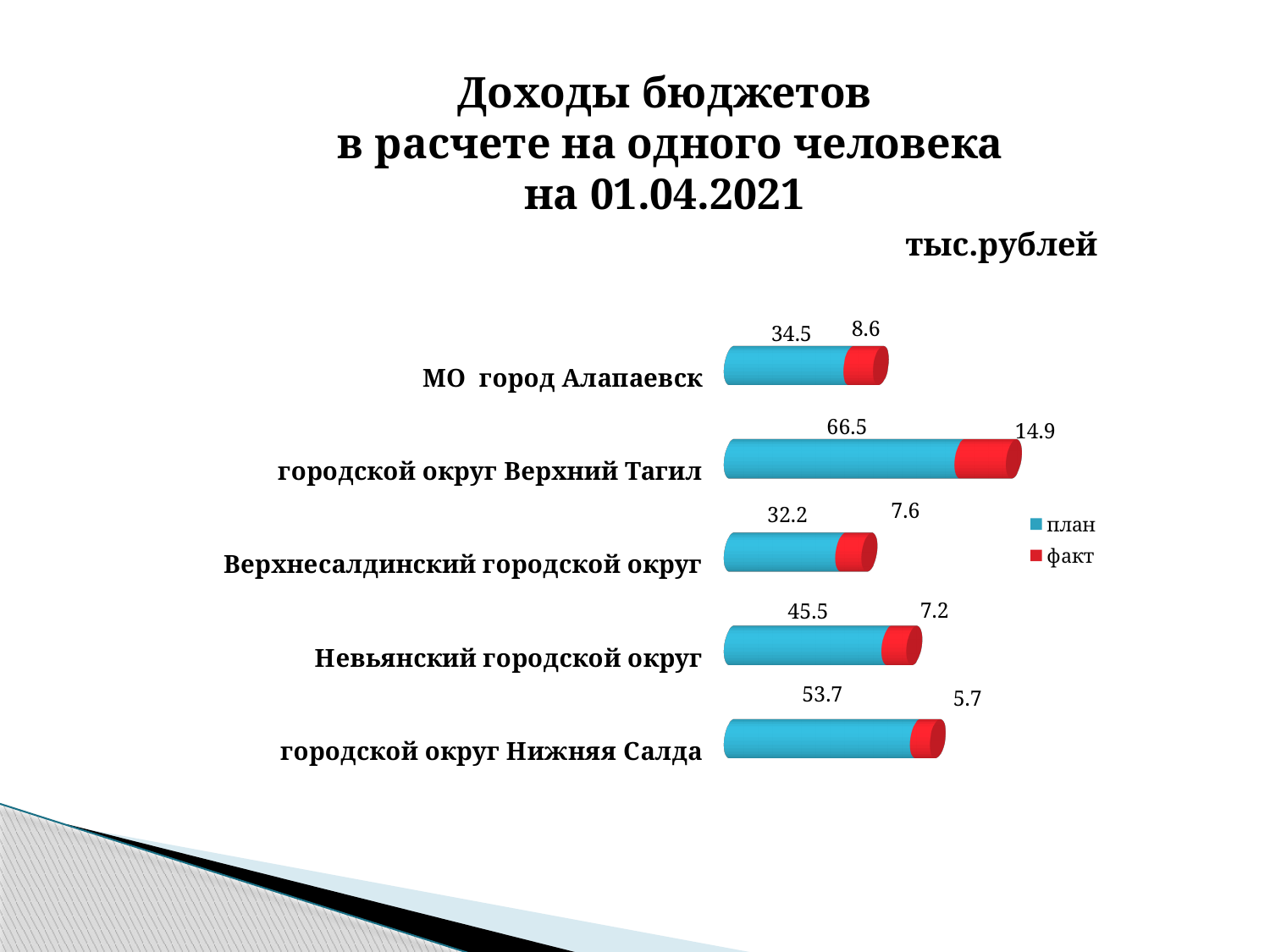
Which category has the lowest план value? Верхнесалдинский городской округ What is the план value for МО город Алапаевск? 34.5 Which category has the highest факт value? городской округ Верхний Тагил What is the план value for городской округ Верхний Тагил? 66.5 What is the total of the stacked bar for городской округ Верхний Тагил (план plus факт)? 81.4 What is the факт value for городской округ Нижняя Салда? 5.7 Which is larger: the факт value for МО город Алапаевск or for Верхнесалдинский городской округ? МО город Алапаевск What unit is stated for the values in the chart? тыс.рублей What is the difference between the план values for городской округ Нижняя Салда and Невьянский городской округ? 8.2 How many series does the legend list? 2 How many categories are shown in the chart? 5 What kind of chart is shown on the slide? bar chart